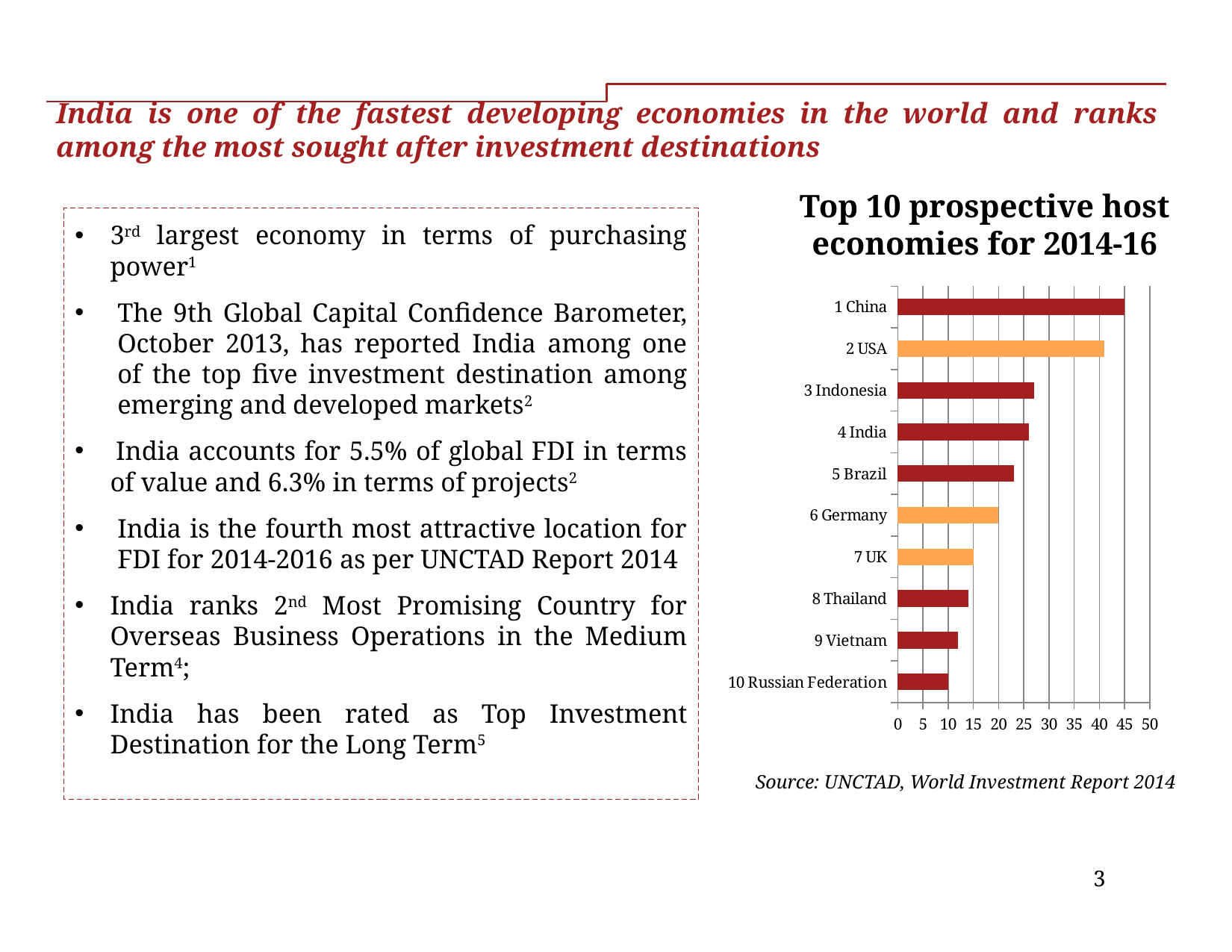
Which economy has the longest bar in the chart? China Is the value for Vietnam greater or less than 10? greater Do the bar values increase or decrease going from the top of the chart to the bottom? decrease Is the value for India greater or less than 30? less Which has the larger value, China or USA? China Which has the larger value, Indonesia or Brazil? Indonesia How many economies are listed in the chart? 10 Is the value for China greater or less than 40? greater What is the title of the chart? Top 10 prospective host economies for 2014-16 What kind of chart is shown on the slide? bar chart Which economy has the shortest bar in the chart? Russian Federation